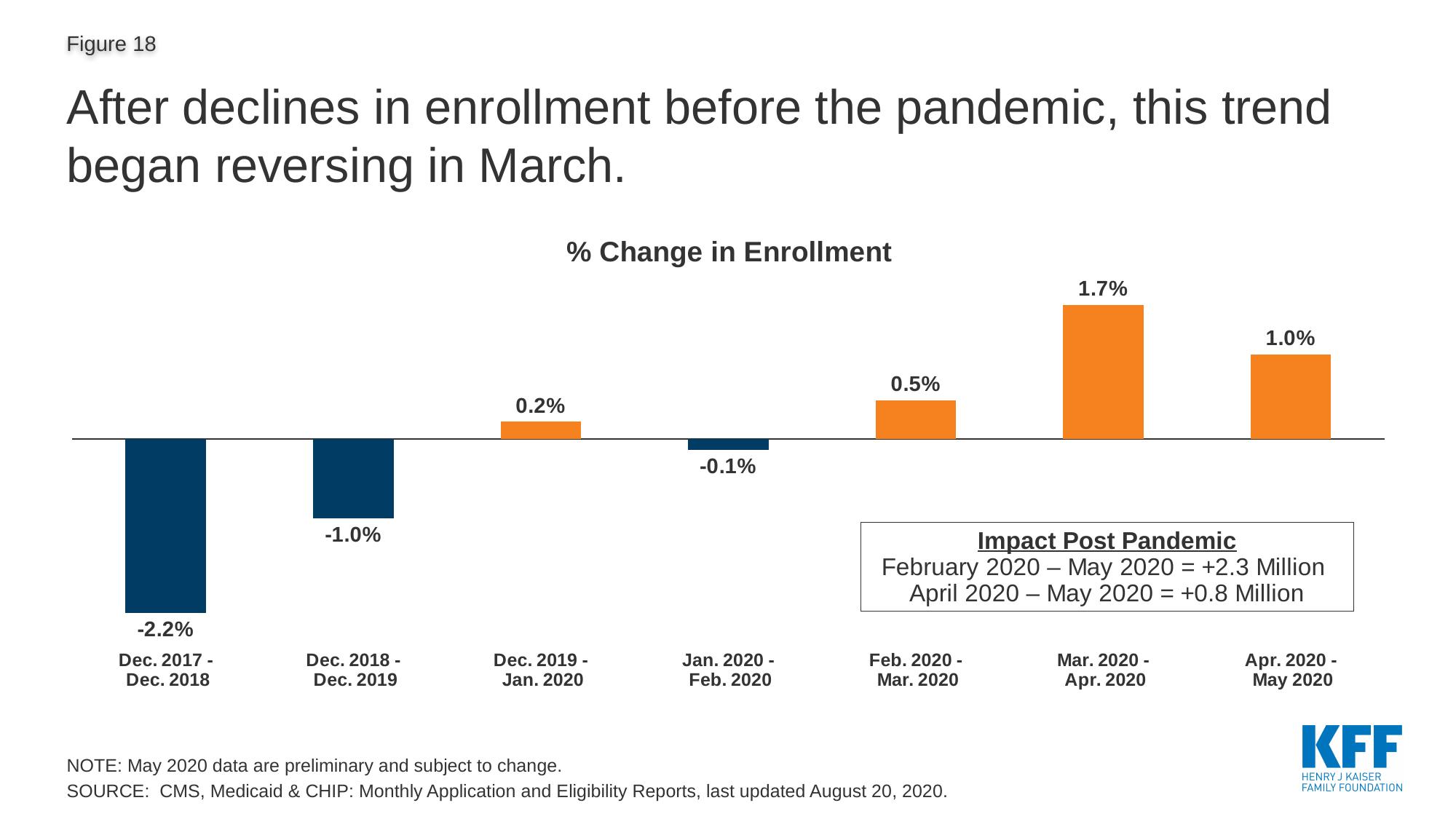
What is the % change in enrollment for Mar. 2020 - Apr. 2020? 1.7% What is the title of the chart? % Change in Enrollment What is the % change in enrollment for Jan. 2020 - Feb. 2020? -0.1% What is the difference between the % change for Mar. 2020 - Apr. 2020 and Feb. 2020 - Mar. 2020? 1.2% What is the % change in enrollment for Apr. 2020 - May 2020? 1.0% Which period has the highest % change in enrollment? Mar. 2020 - Apr. 2020 Which is larger, the % change for Dec. 2019 - Jan. 2020 or for Feb. 2020 - Mar. 2020? Feb. 2020 - Mar. 2020 How many periods are shown in the chart? 7 How many bars in the chart show a negative % change in enrollment? 3 What kind of chart is shown on the slide? Bar chart Which period has the lowest % change in enrollment? Dec. 2017 - Dec. 2018 What is the % change in enrollment for Dec. 2017 - Dec. 2018? -2.2%